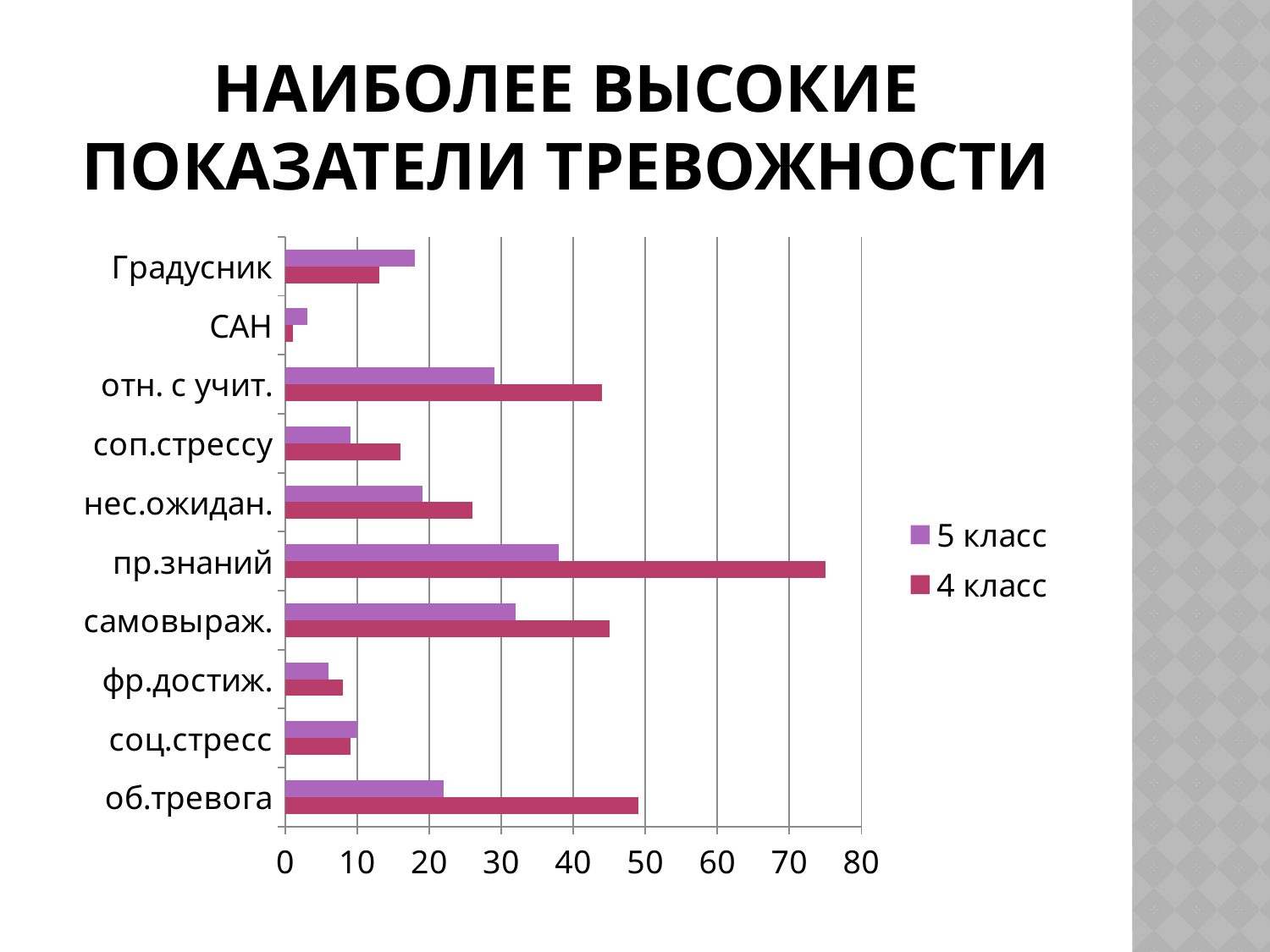
How many categories are shown on the chart? 10 For Градусник, which series has the larger value, 5 класс or 4 класс? 5 класс How many series does the legend list? 2 For об.тревога, which series has the larger value, 5 класс or 4 класс? 4 класс What kind of chart is shown on the slide? bar chart Which category has the lowest value for the 4 класс series? САН Is the 4 класс value for соп.стрессу greater or less than 20? less Which category has the highest value for the 5 класс series? пр.знаний Is the 4 класс value for пр.знаний greater or less than 70? greater What is the title of the slide above the chart? НАИБОЛЕЕ ВЫСОКИЕ ПОКАЗАТЕЛИ ТРЕВОЖНОСТИ Is the 4 класс value for отн. с учит. greater or less than 40? greater Which category has the highest value for the 4 класс series? пр.знаний